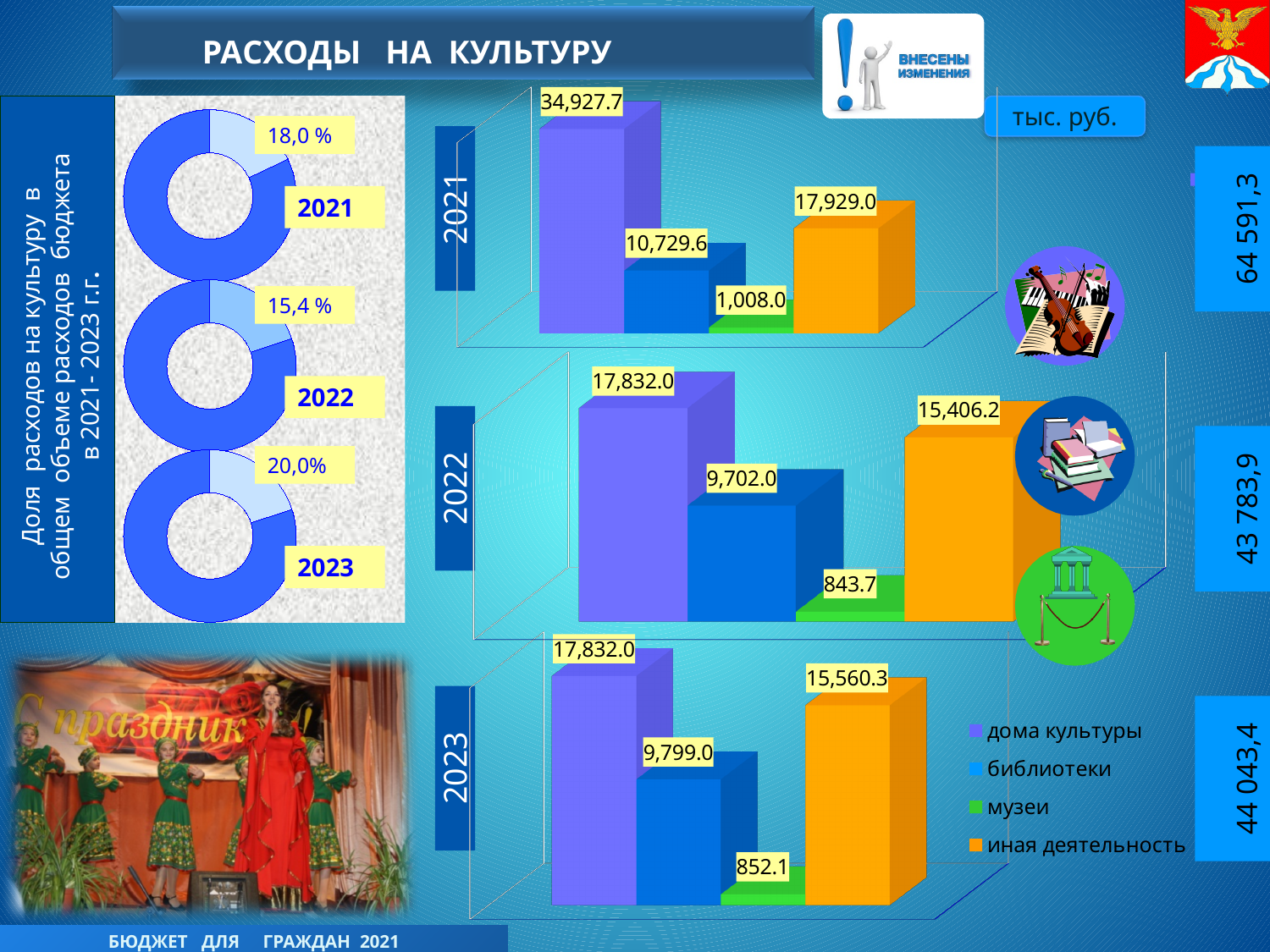
In the 2023 bar chart, what is the value for музеи? 852.1 In the 2023 bar chart, what is the value for библиотеки? 9,799.0 In the 2022 bar chart, which category has the lowest value? музеи How many series does the legend of the bar charts list? 4 In the 2021 bar chart, what is the value for дома культуры? 34,927.7 In the 2022 bar chart, what is the value for иная деятельность? 15,406.2 What unit is stated for the values in the bar charts? тыс. руб. In the 2021 bar chart, which category has the highest value? дома культуры In the donut chart for 2022, what share of total budget expenditure goes to culture? 15,4 % In the 2021 bar chart, what is the difference between дома культуры and иная деятельность? 16,998.7 In the 2023 bar chart, which is larger: дома культуры or иная деятельность? дома культуры What kind of chart is used to show the 2022 expenditure by category? bar chart